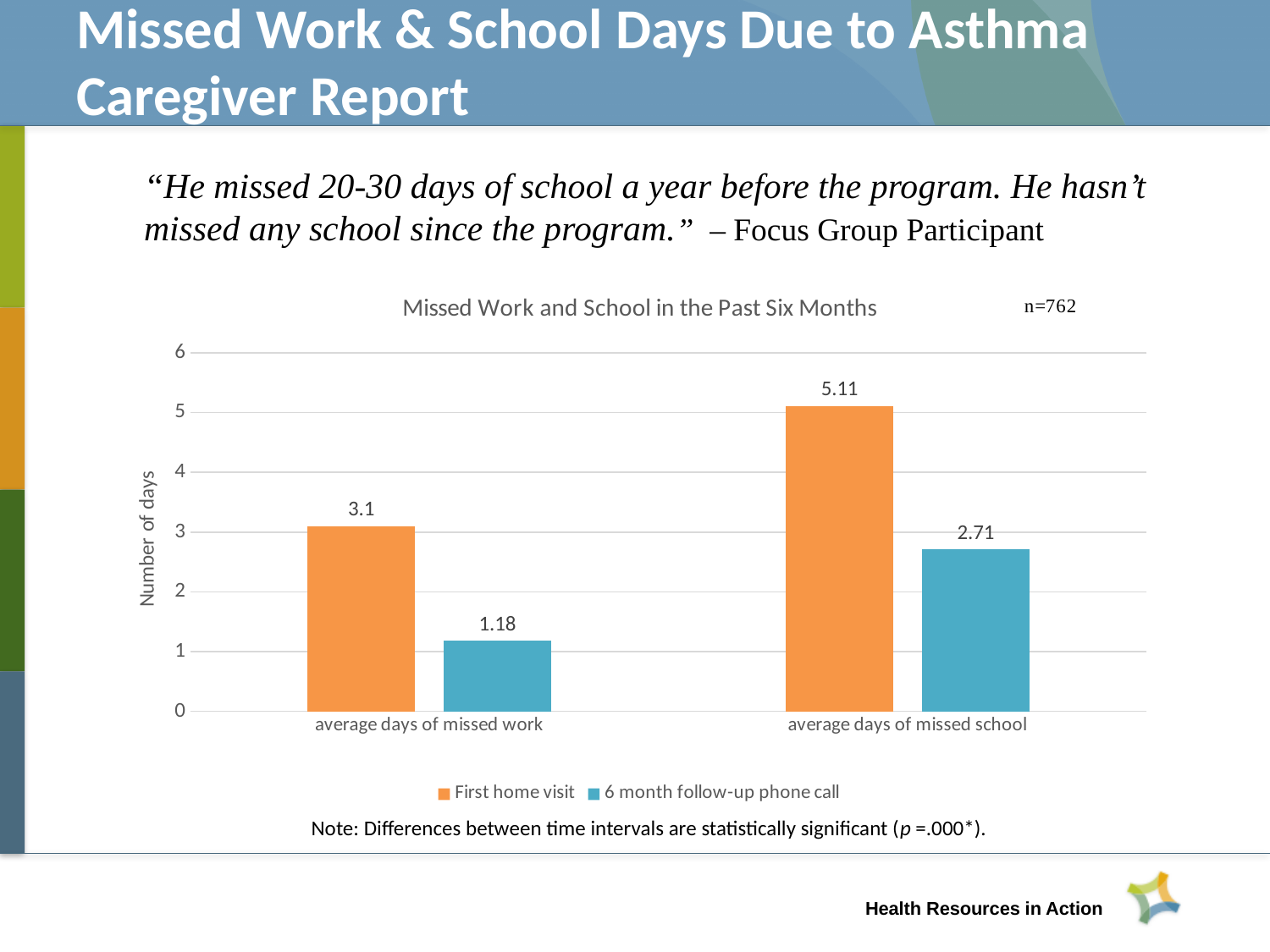
Which bar has the highest value in the chart? First home visit, average days of missed school How many series does the legend list? 2 Which is larger: the 'First home visit' value for 'average days of missed work' or the '6 month follow-up phone call' value for 'average days of missed school'? First home visit value for average days of missed work What is the difference between the 'First home visit' and '6 month follow-up phone call' values for 'average days of missed work'? 1.92 What is the difference between the 'First home visit' and '6 month follow-up phone call' values for 'average days of missed school'? 2.4 Which bar has the lowest value in the chart? 6 month follow-up phone call, average days of missed work What is the title of the chart? Missed Work and School in the Past Six Months What is the value for 'First home visit' in the 'average days of missed work' category? 3.1 What is the value for '6 month follow-up phone call' in the 'average days of missed school' category? 2.71 What is the value for '6 month follow-up phone call' in the 'average days of missed work' category? 1.18 How many categories are shown on the x axis? 2 What kind of chart is shown on the slide? Bar chart